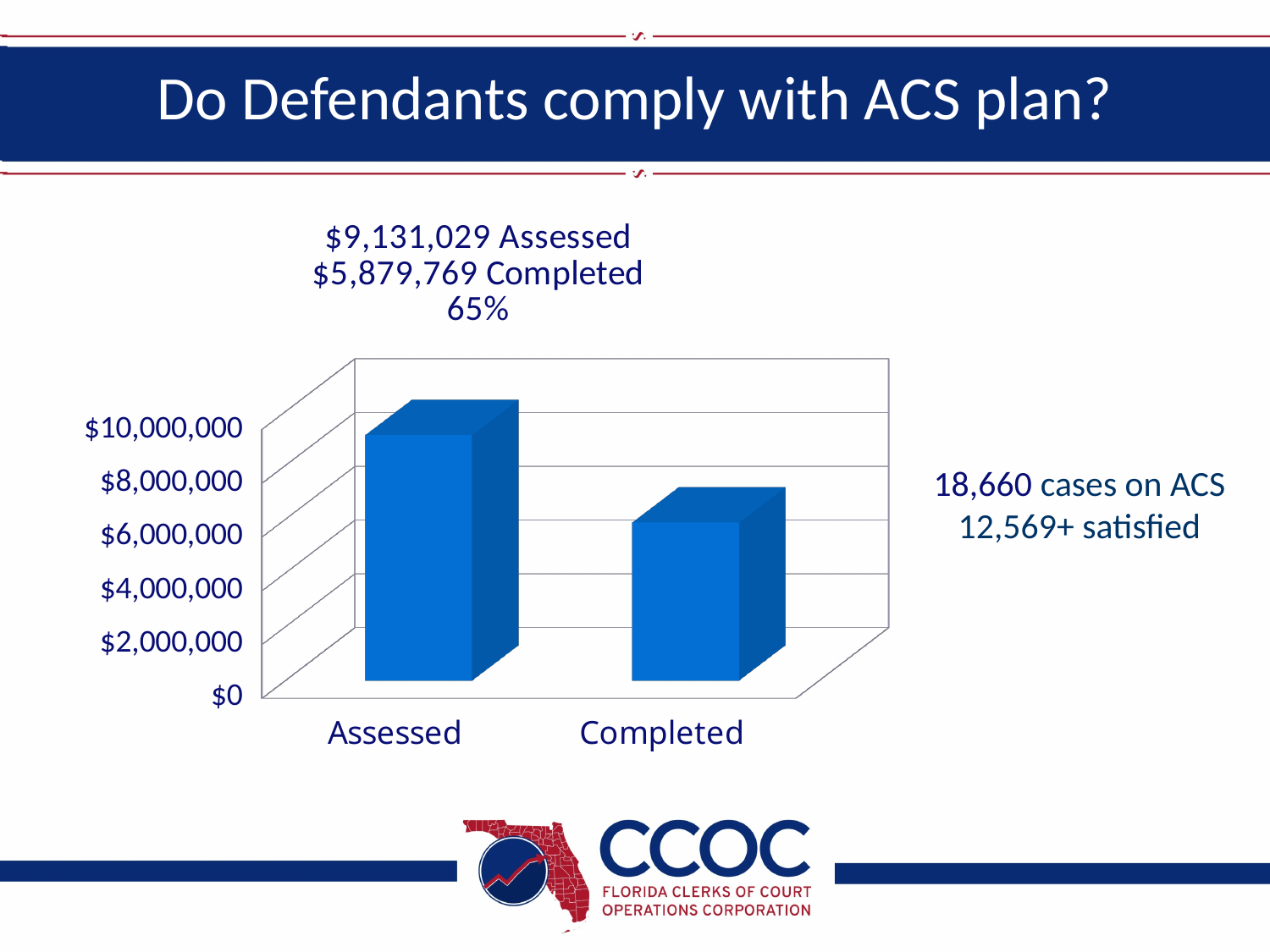
How many categories are plotted in the chart? 2 What is the title of the slide containing the chart? Do Defendants comply with ACS plan? What type of chart is shown on the slide? bar chart Which category has the lowest value in the chart? Completed What percentage of the assessed amount was completed, according to the slide? 65% Is the value for Assessed greater or less than $8,000,000? greater Which category has the highest value in the chart? Assessed What is the difference between the Assessed amount and the Completed amount? $3,251,260 Is the value for Completed greater or less than $4,000,000? greater Which is larger, the value for Assessed or the value for Completed? Assessed What is the amount assessed, as printed on the slide? $9,131,029 What is the amount completed, as printed on the slide? $5,879,769